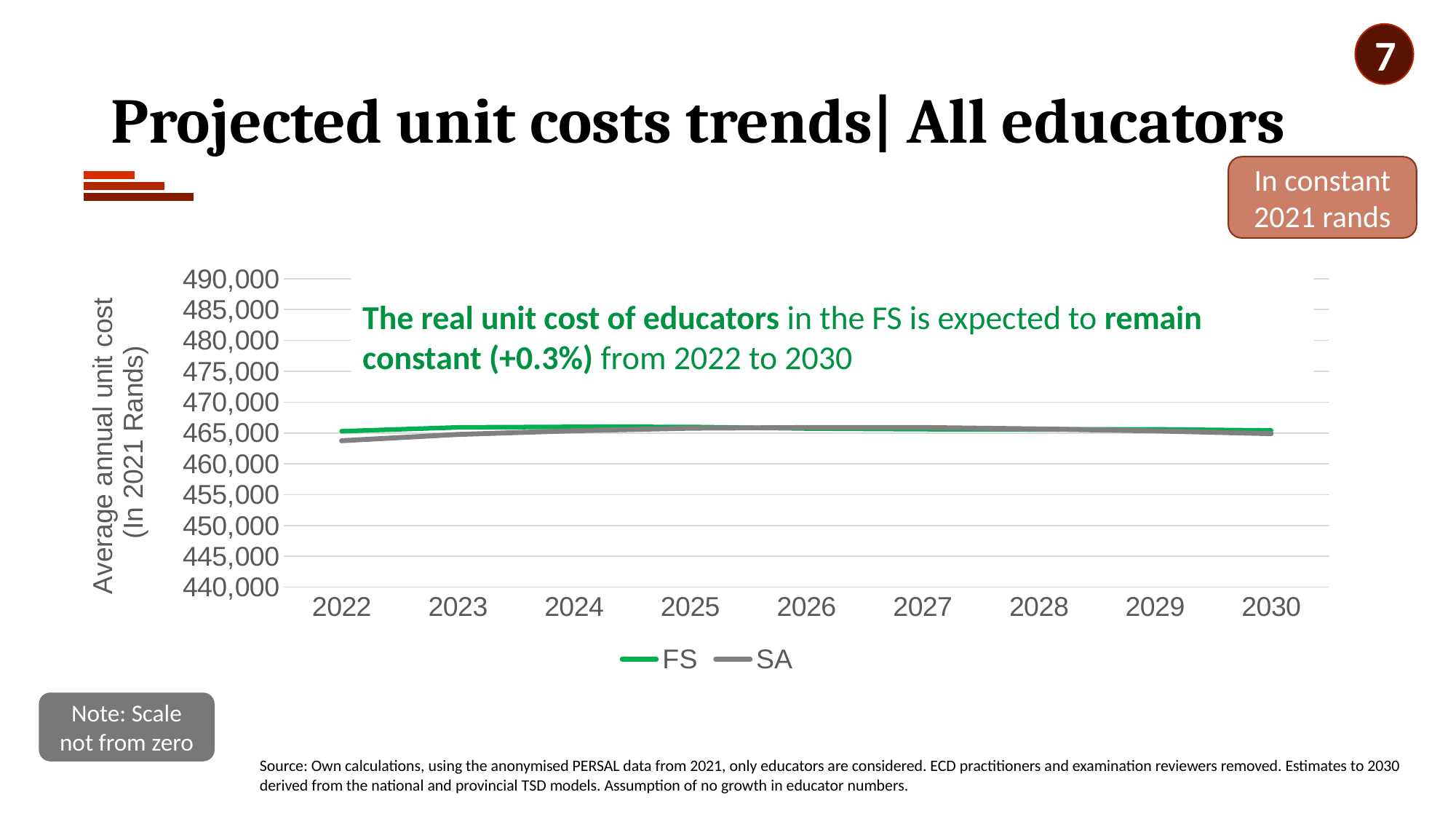
Do the FS values rise sharply, fall sharply, or stay roughly flat from 2022 to 2030? stay roughly flat What are the two series named in the legend? FS and SA Is the value for SA in 2030 greater or less than 460,000? greater What is the lowest value shown on the y axis? 440,000 What kind of chart is shown on the slide? line chart Is the value for SA in 2022 greater or less than 470,000? less Is the value for FS in 2022 greater or less than 460,000? greater How many series does the legend list? 2 In 2022, which series has the higher value, FS or SA? FS How many years are plotted along the x axis? 9 Which year is the first on the x axis? 2022